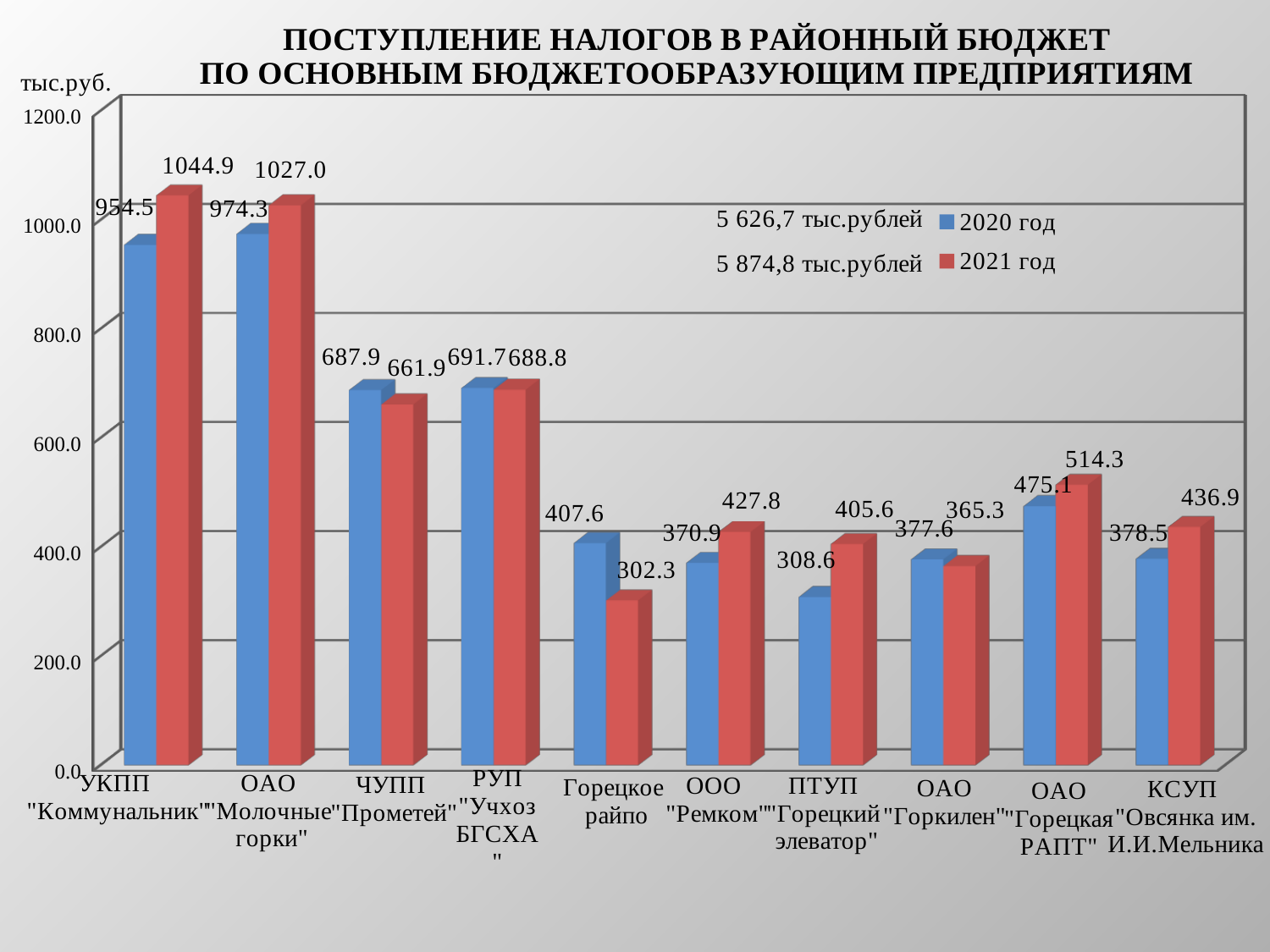
Is the 2021 год value for ОАО "Горецкая РАПТ" greater or less than 400? greater What is the value for Горецкое райпо in 2020 год? 407.6 Which is larger for ЧУПП "Прометей": the 2020 год value or the 2021 год value? 2020 год Which enterprise has the lowest value in 2021 год? Горецкое райпо What is the value for УКПП "Коммунальник" in 2021 год? 1044.9 Which enterprise has the highest value in 2020 год? ОАО "Молочные горки" Which colour represents 2021 год in the chart? red What is the difference between the 2021 год and 2020 год values for ООО "Ремком"? 56.9 How many enterprises (categories) are shown on the x axis? 10 What is the value for ПТУП "Горецкий элеватор" in 2021 год? 405.6 What type of chart is shown on the slide? bar chart How many series does the legend list? 2